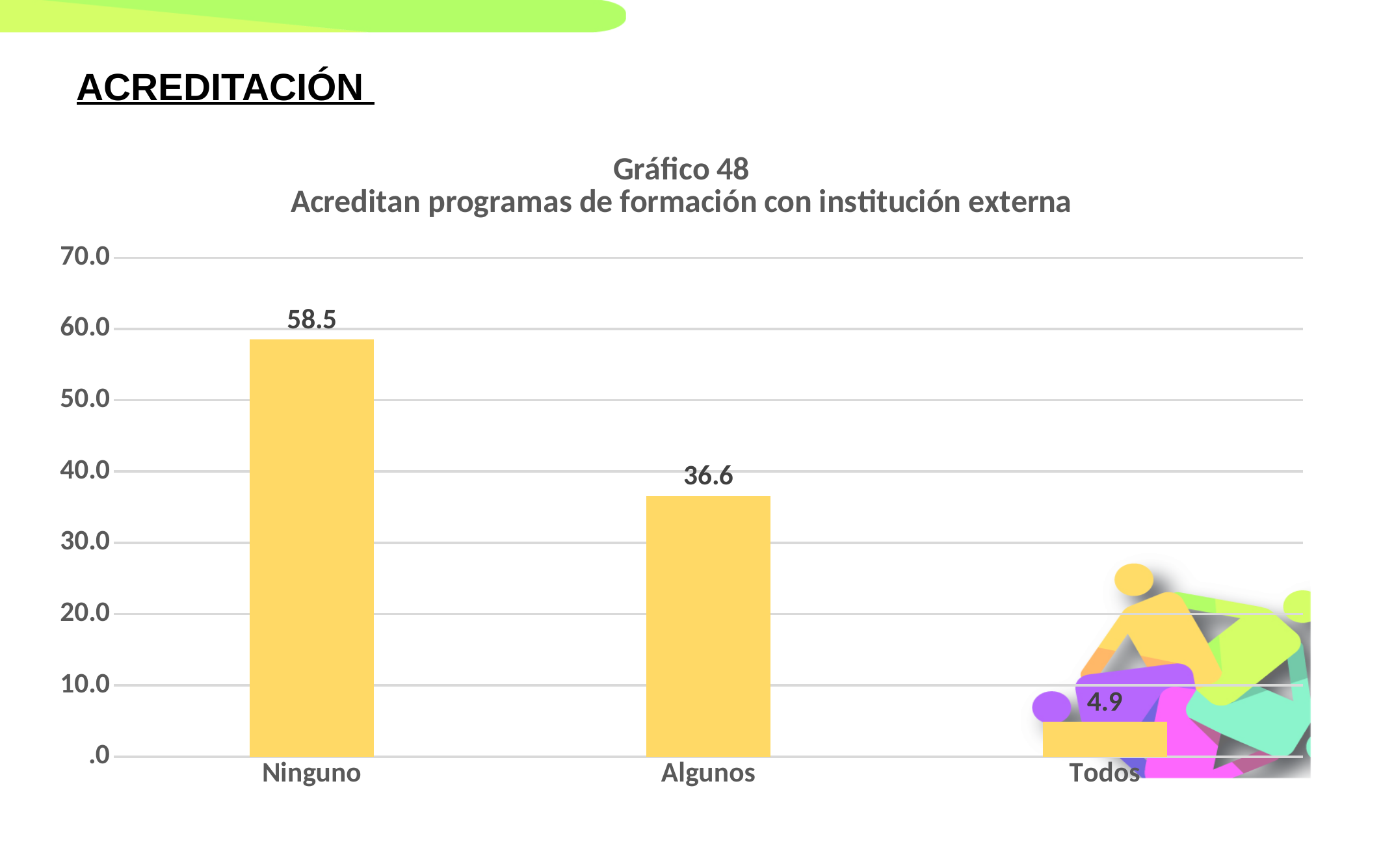
Which is larger, the value for Algunos or the value for Todos? Algunos What kind of chart is shown on the slide? bar chart What is the title of the chart? Gráfico 48 Acreditan programas de formación con institución externa Which category has the lowest value? Todos What is the value for Algunos? 36.6 What is the value for Todos? 4.9 What is the value for Ninguno? 58.5 What is the difference between the values for Ninguno and Algunos? 21.9 What is the difference between the values for Algunos and Todos? 31.7 Which category has the highest value? Ninguno How many categories are shown on the x axis? 3 Is the value for Ninguno greater or less than 50.0? greater